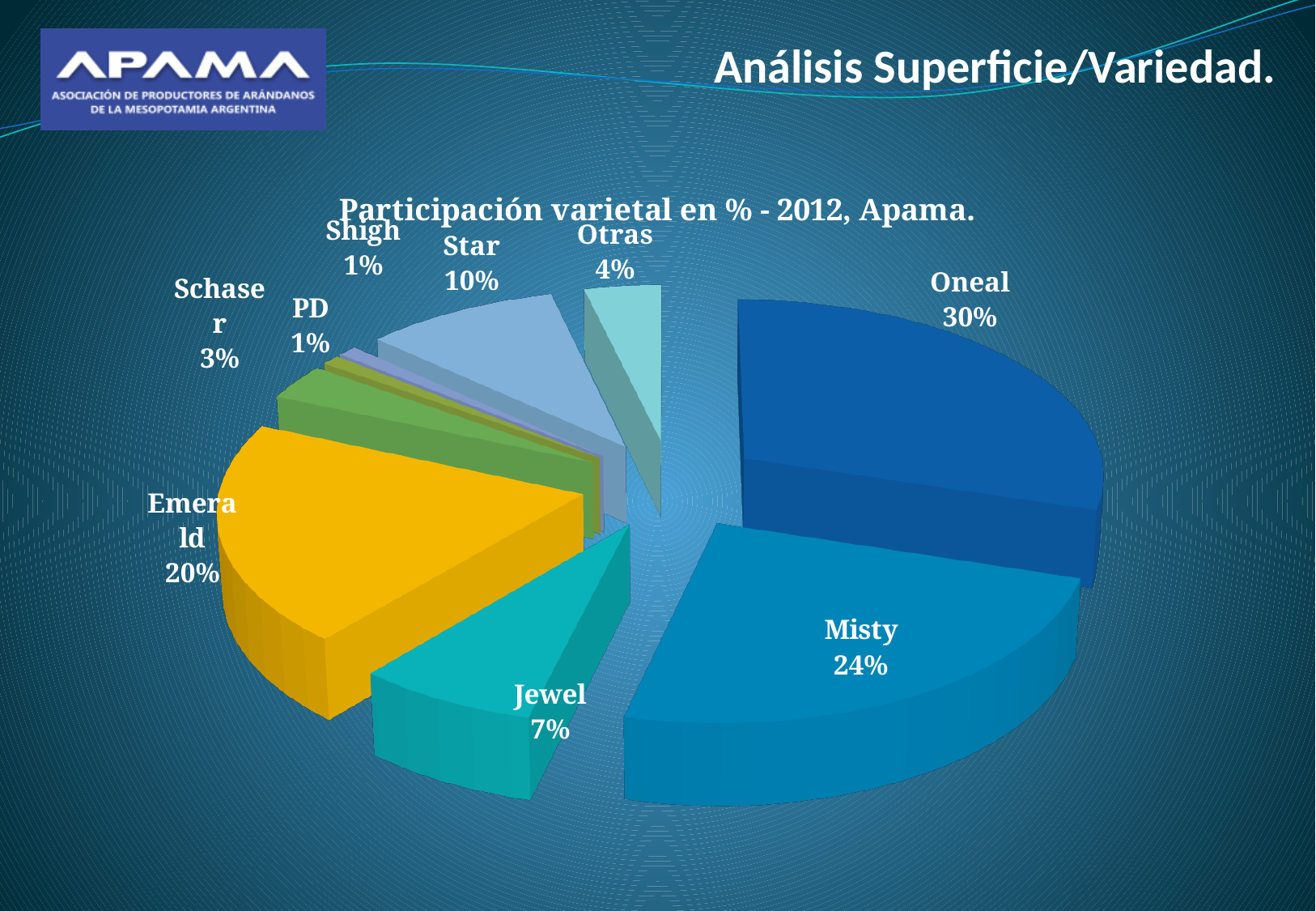
What is the difference in share between Oneal and Misty? 6% Which has a larger share, Star or Jewel? Star What kind of chart is shown on the slide? pie chart What share does Oneal have in the pie chart? 30% How many slices does the pie chart have? 9 What share does Misty have in the pie chart? 24% What share does Jewel have in the pie chart? 7% What is the title of the chart? Participación varietal en % - 2012, Apama. What share does Otras have in the pie chart? 4% Which variety has the largest share in the pie chart? Oneal What share does Star have in the pie chart? 10% What share does Emerald have in the pie chart? 20%